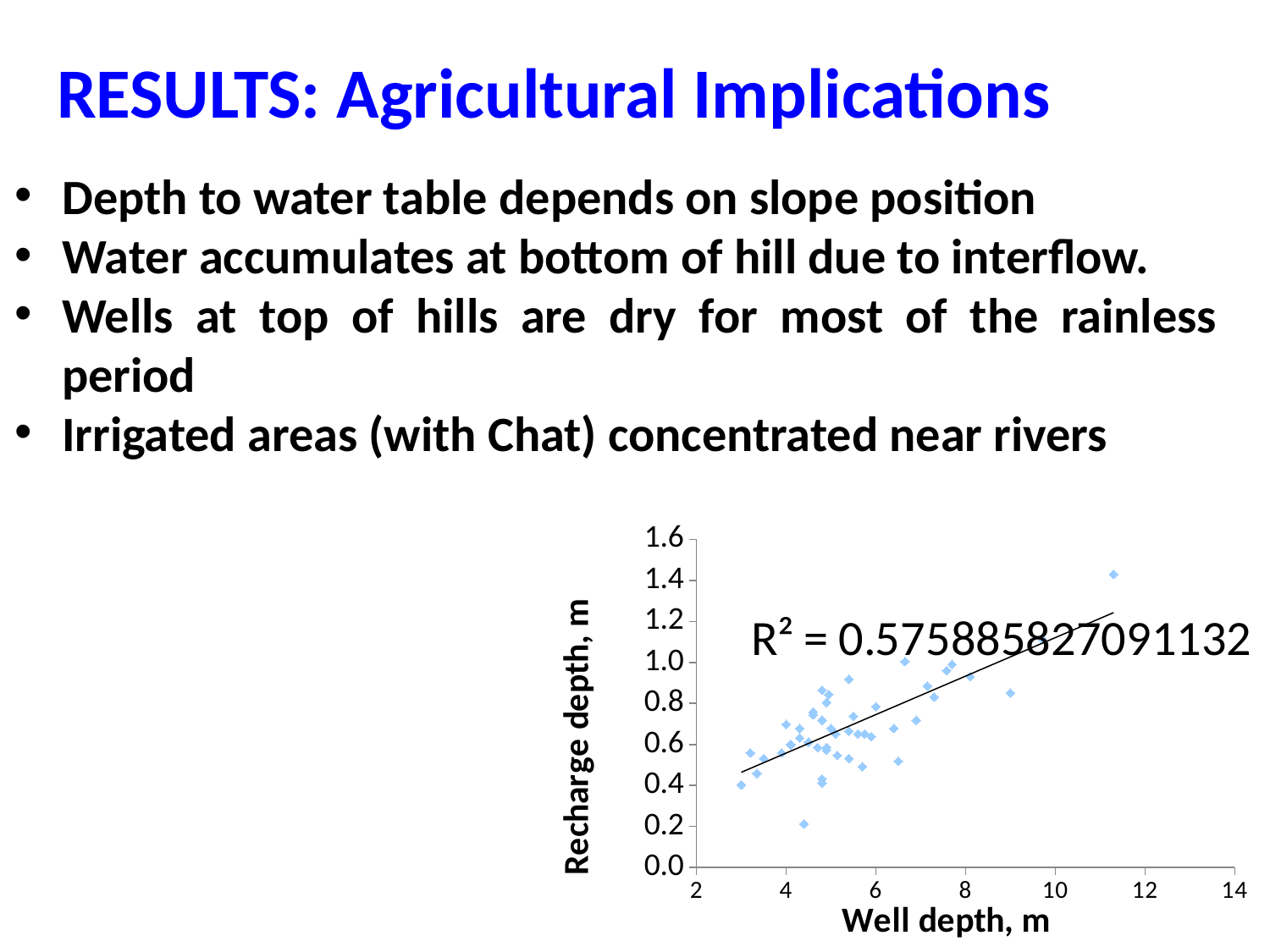
Is the largest well depth plotted greater or less than 10? greater What is the label of the y axis of the chart? Recharge depth, m Is the lowest recharge depth value plotted greater or less than 0.4? less What is the label of the x axis of the chart? Well depth, m What is the maximum value shown on the y axis of the chart? 1.6 Is the highest recharge depth value plotted greater or less than 1.2? greater What kind of chart is shown on the slide? scatter chart Does recharge depth generally rise or fall as well depth increases along the x axis? rise